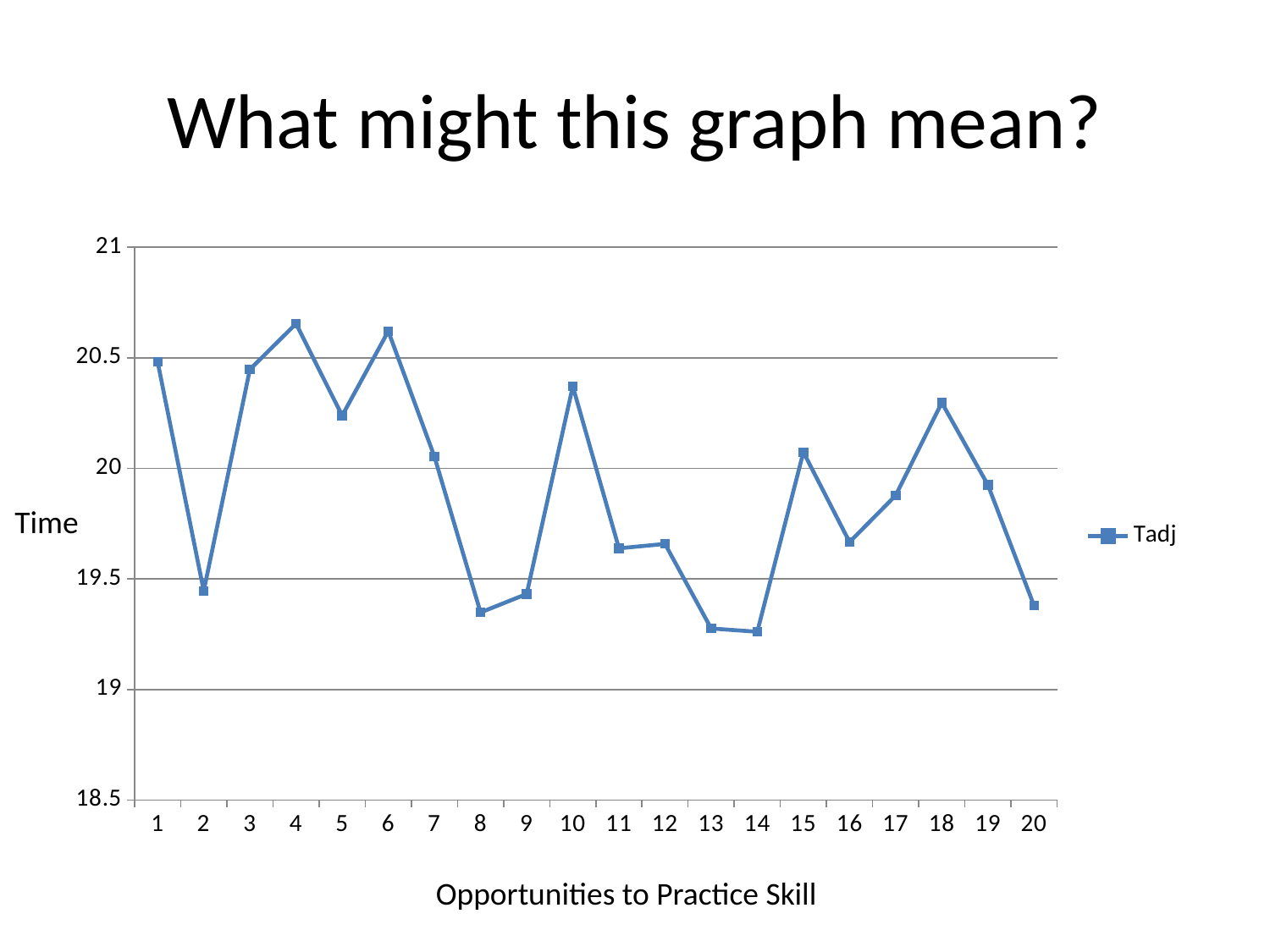
Overall, do the values rise or fall from opportunity 1 to opportunity 20? fall Is the value for opportunity 4 greater or less than 20.5? greater How many data points are plotted along the x axis? 20 Is the value for opportunity 11 greater or less than 20? less How many series does the legend list? 1 Which has the larger value, opportunity 10 or opportunity 14? opportunity 10 What is the name of the series shown in the legend? Tadj Is the value for opportunity 8 greater or less than 19.5? less What kind of chart is shown on the slide? line chart Which has the larger value, opportunity 1 or opportunity 2? opportunity 1 What is the title of the x axis? Opportunities to Practice Skill